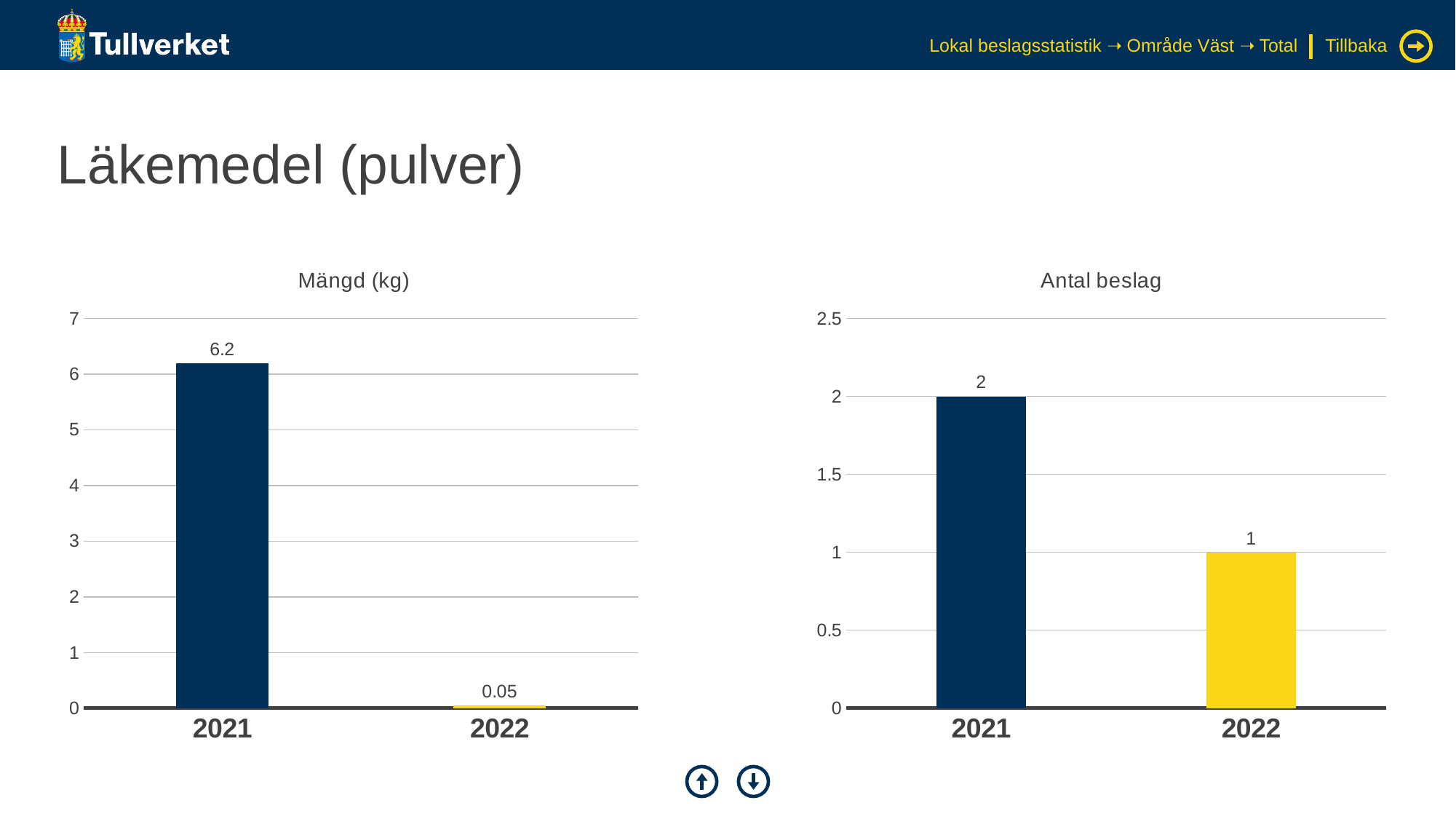
How many categories are shown on the x axis of the 'Mängd (kg)' chart? 2 In the 'Mängd (kg)' chart, which year has the highest value? 2021 In the 'Antal beslag' chart, which is larger, the value for 2021 or 2022? 2021 In the 'Mängd (kg)' chart, do the values rise or fall from 2021 to 2022? Fall In the 'Antal beslag' chart, what is the difference between the 2021 and 2022 values? 1 In the 'Antal beslag' chart, what is the value for 2022? 1 In the 'Antal beslag' chart, which year has the lowest value? 2022 In the 'Mängd (kg)' chart, what is the value for 2022? 0.05 In the 'Mängd (kg)' chart, what is the value for 2021? 6.2 In the 'Mängd (kg)' chart, what is the difference between the 2021 and 2022 values? 6.15 What kind of chart is the 'Antal beslag' chart? Bar chart In the 'Antal beslag' chart, what is the value for 2021? 2